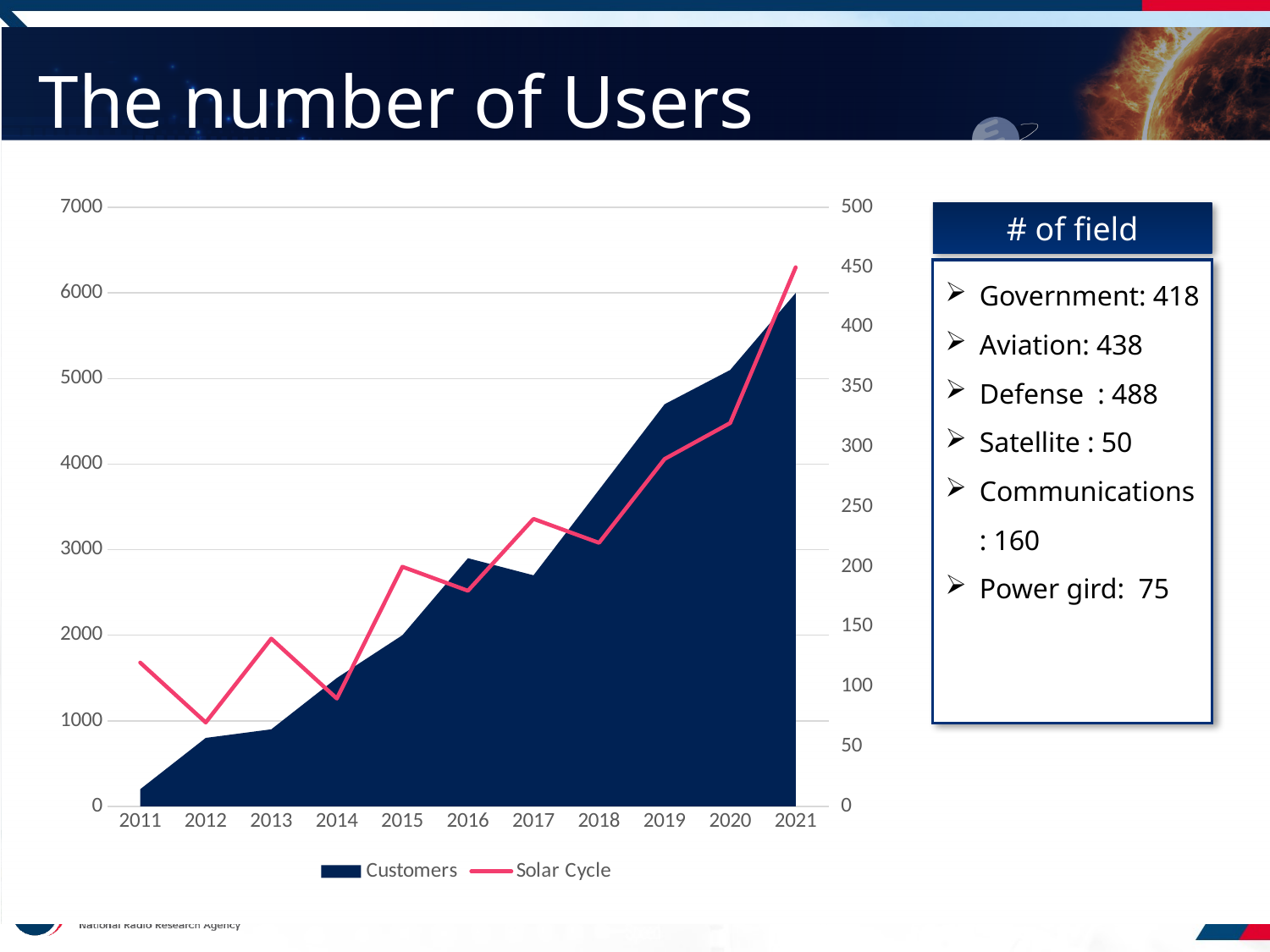
Is the Customers value for 2021 greater or less than 5000? greater Do the Customers values generally rise or fall from 2011 to 2021? rise Is the Customers value for 2015 greater or less than 3000? less How many series does the chart legend list? 2 In which year is the Customers value highest? 2021 In which year is the Customers value lowest? 2011 What kind of chart is shown on the slide? A combined area and line chart Is the Solar Cycle value for 2021 greater or less than 400 on the right axis? greater Which year has the larger Customers value, 2016 or 2019? 2019 How many years are shown along the x axis of the chart? 11 In which year is the Solar Cycle value highest? 2021 In which year is the Solar Cycle value lowest? 2012